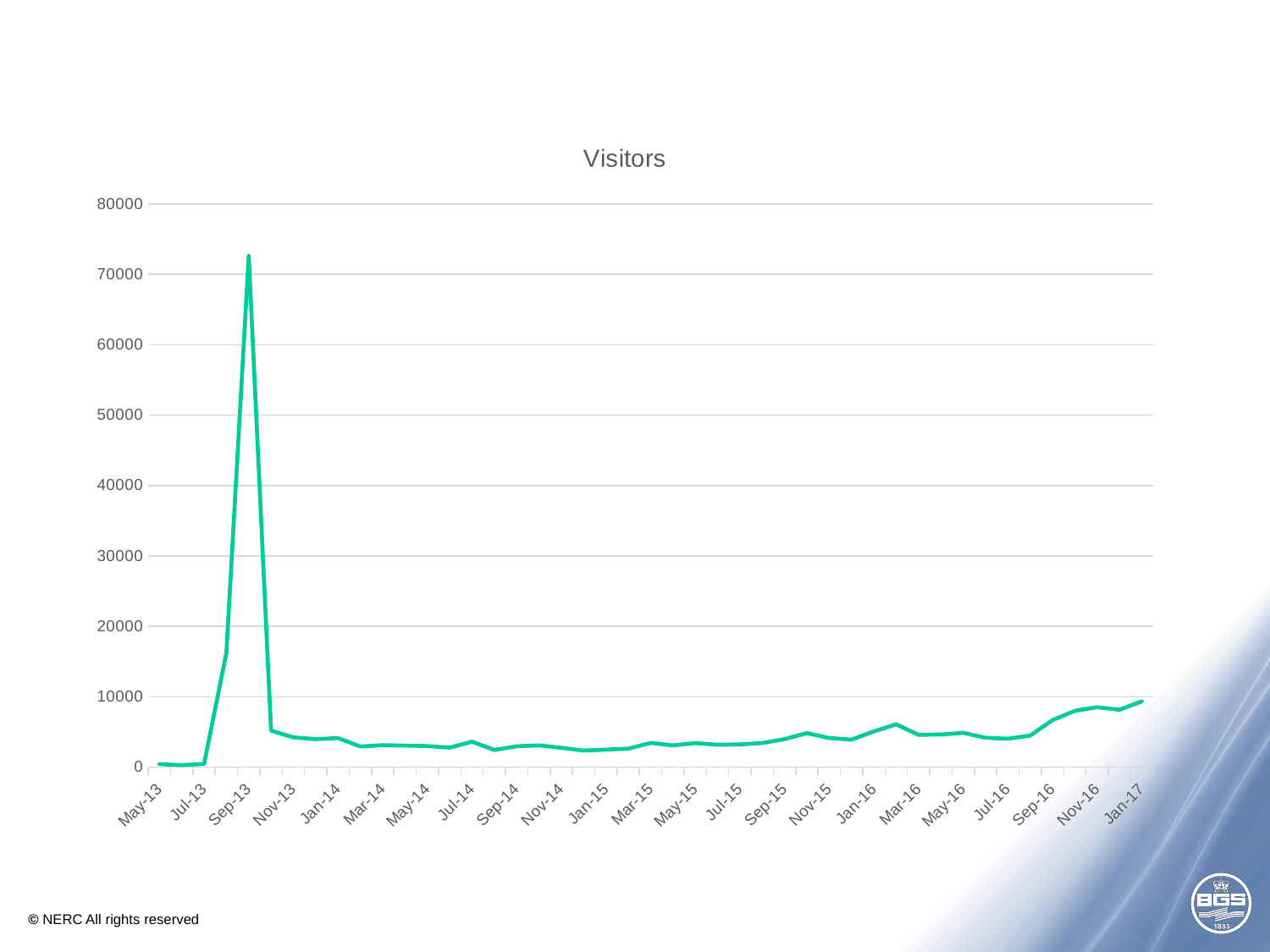
Is the value for Jan-17 greater or less than 20000? less Do the values rise or fall between Sep-13 and Nov-13? fall What is the highest value shown on the y axis? 80000 Is the value for Mar-14 greater or less than 10000? less Is the value for Jul-13 greater or less than 10000? less At which month does the Visitors line reach its highest value? Sep-13 What is the title of the chart? Visitors Which is larger, the value for Jan-17 or the value for May-13? Jan-17 What kind of chart is shown on the slide? line chart Do the values rise or fall between Jul-16 and Jan-17? rise Which is larger, the value for Sep-13 or the value for Jan-17? Sep-13